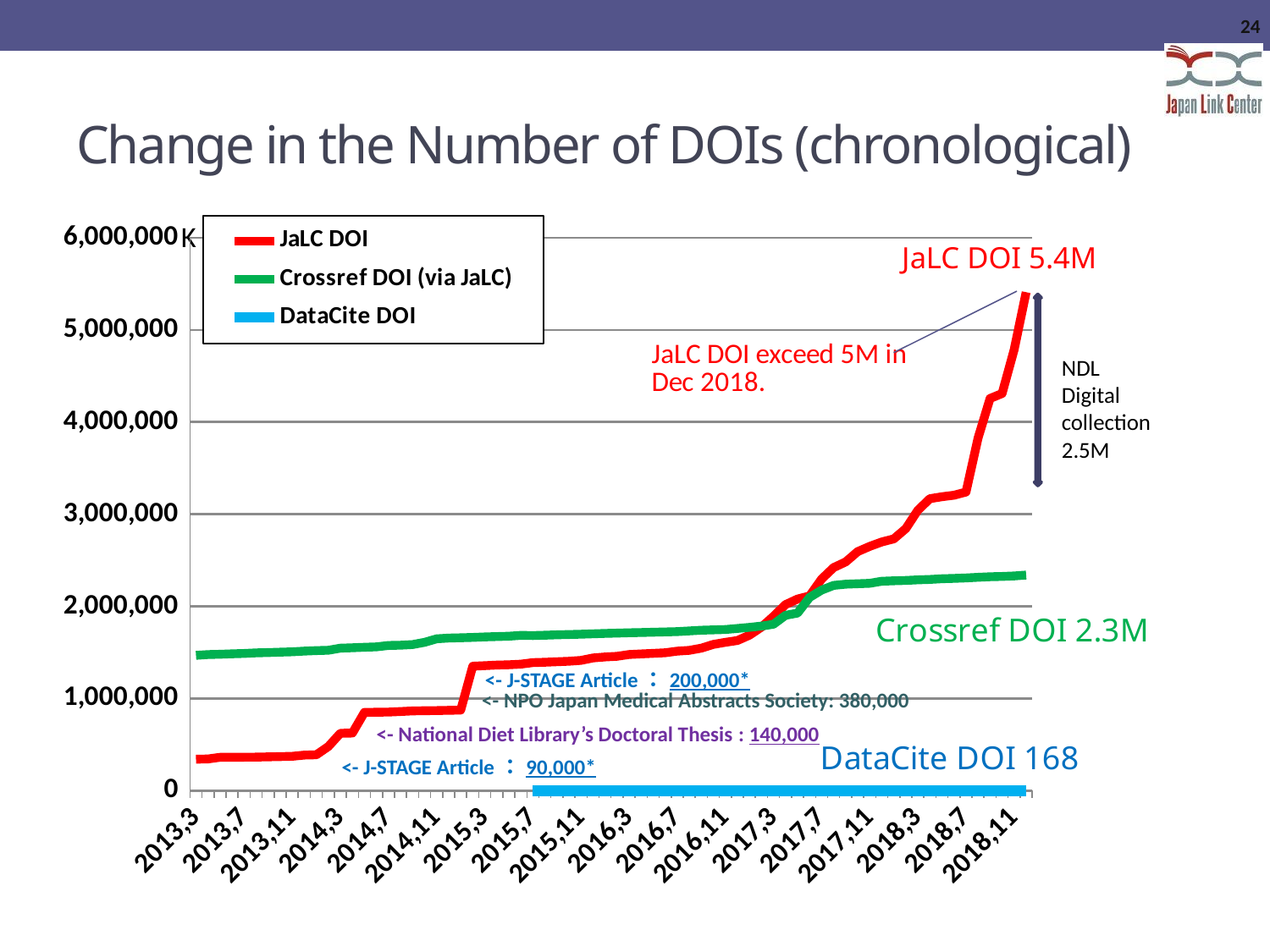
What colour is the JaLC DOI line? red What kind of chart is shown on the slide? line chart Which series has the highest value at 2018.11? JaLC DOI How many series does the legend list? 3 What is the title of the chart? Change in the Number of DOIs (chronological) Which series has the lowest value at 2018.11? DataCite DOI At 2013.3, which is larger: JaLC DOI or Crossref DOI (via JaLC)? Crossref DOI (via JaLC) According to the annotation, what is the latest number of Crossref DOIs? 2.3M Does the JaLC DOI line rise or fall from 2013.3 to 2018.11? rise According to the annotation, what is the latest number of JaLC DOIs? 5.4M Is the value for JaLC DOI at 2013.3 greater or less than 1,000,000? less According to the annotation, what is the number of DataCite DOIs? 168